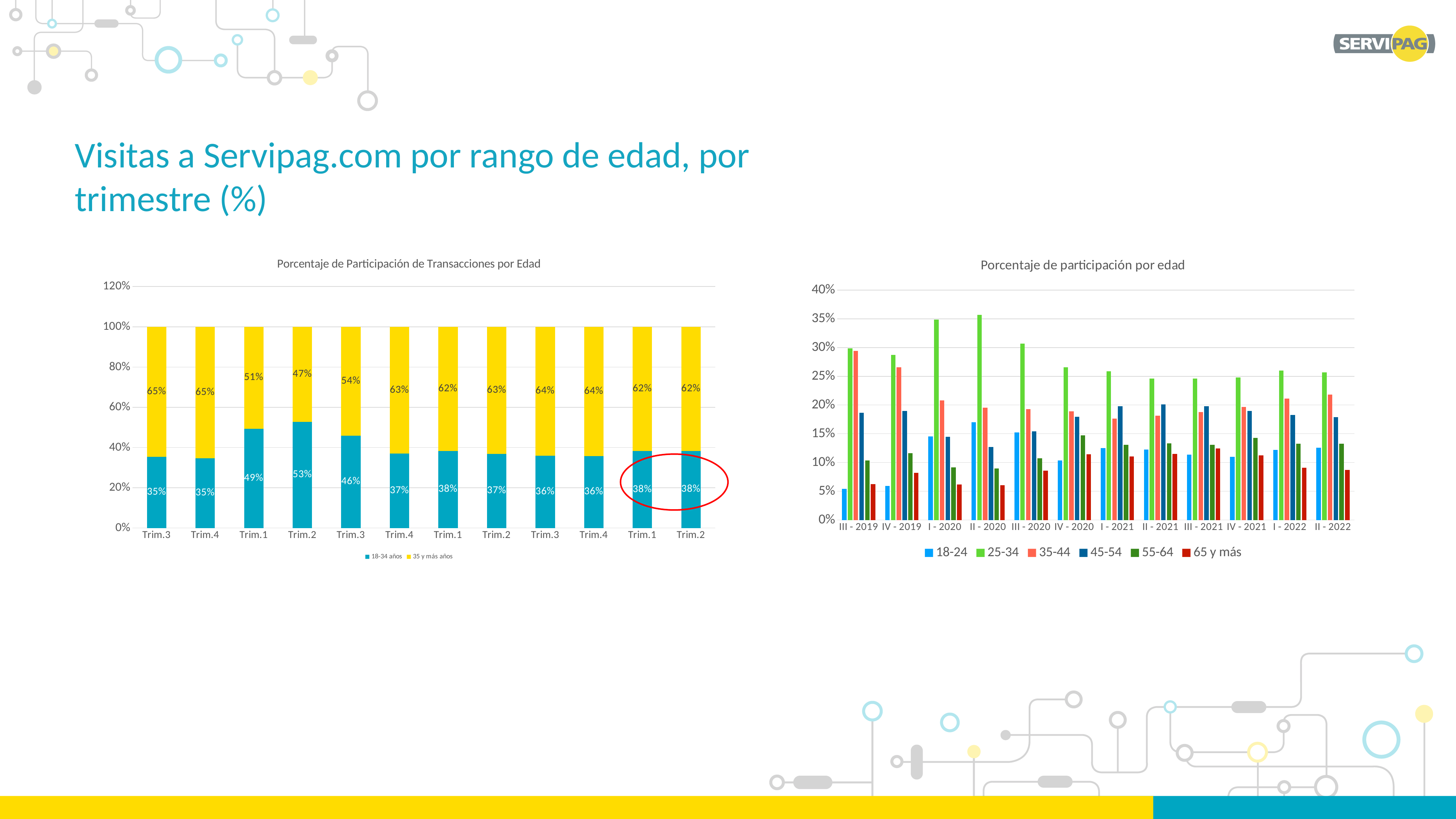
In the right chart 'Porcentaje de participación por edad', is the value for 18-24 in III - 2019 greater or less than 10%? less In the right chart 'Porcentaje de participación por edad', which age group has the highest value in I - 2020? 25-34 In the right chart 'Porcentaje de participación por edad', how many quarters are shown on the x axis? 12 In the left chart 'Porcentaje de Participación de Transacciones por Edad', what is the 35 y más años value for the first bar (Trim.3)? 65% In the left chart 'Porcentaje de Participación de Transacciones por Edad', what is the 18-34 años value for the third bar from the left (the first Trim.1)? 49% What kind of chart is the left chart titled 'Porcentaje de Participación de Transacciones por Edad'? Stacked bar chart In the left chart 'Porcentaje de Participación de Transacciones por Edad', what is the highest value shown for 18-34 años? 53% In the left chart 'Porcentaje de Participación de Transacciones por Edad', how many series does the legend list? 2 In the left chart 'Porcentaje de Participación de Transacciones por Edad', what is the lowest value shown for 35 y más años? 47% In the right chart 'Porcentaje de participación por edad', how many series does the legend list? 6 In the left chart 'Porcentaje de Participación de Transacciones por Edad', what is the difference between the 18-34 años and 35 y más años values in the fourth bar from the left (the first Trim.2)? 6 percentage points In the left chart 'Porcentaje de Participación de Transacciones por Edad', how many bars are plotted? 12